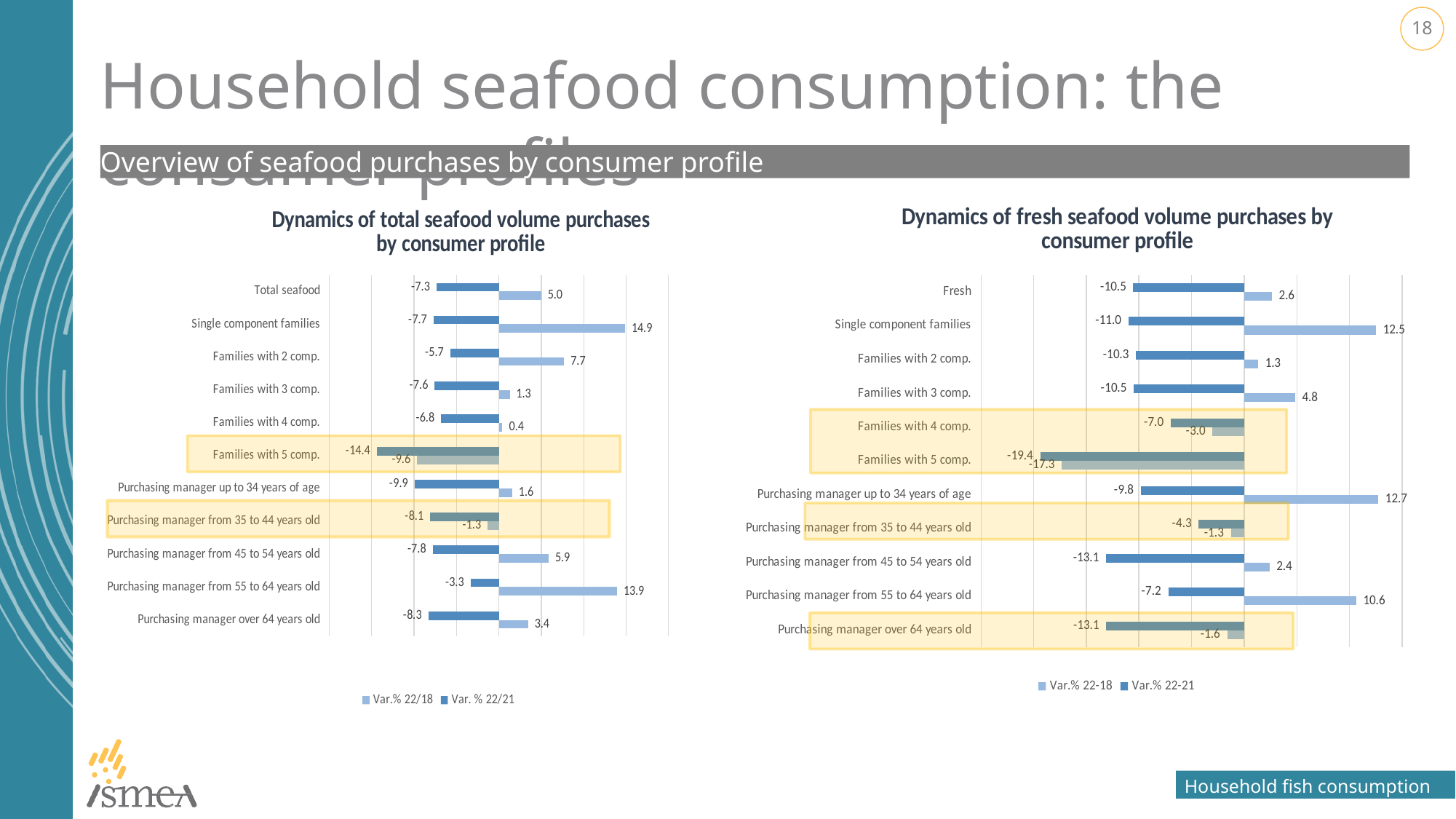
How many series does the legend of the 'Dynamics of fresh seafood volume purchases by consumer profile' chart list? 2 In the 'Dynamics of total seafood volume purchases by consumer profile' chart, what is the Var.% 22/18 value for Single component families? 14.9 In the 'Dynamics of fresh seafood volume purchases by consumer profile' chart, what is the Var.% 22-18 value for Families with 4 comp.? -3.0 In the 'Dynamics of total seafood volume purchases by consumer profile' chart, which category has the highest Var.% 22/18 value? Single component families In the 'Dynamics of total seafood volume purchases by consumer profile' chart, what is the Var. % 22/21 value for Families with 5 comp.? -14.4 In the 'Dynamics of fresh seafood volume purchases by consumer profile' chart, what is the Var.% 22-18 value for Purchasing manager from 55 to 64 years old? 10.6 How many consumer profile categories are shown in the 'Dynamics of total seafood volume purchases by consumer profile' chart? 11 What kind of chart is the 'Dynamics of total seafood volume purchases by consumer profile' chart? Bar chart In the 'Dynamics of fresh seafood volume purchases by consumer profile' chart, which category has the lowest Var.% 22-21 value? Families with 5 comp. In the 'Dynamics of total seafood volume purchases by consumer profile' chart, what is the difference between the Var.% 22/18 values for Single component families and Purchasing manager from 55 to 64 years old? 1.0 In the 'Dynamics of fresh seafood volume purchases by consumer profile' chart, which is larger for Families with 3 comp.: the Var.% 22-18 value or the Var.% 22-21 value? Var.% 22-18 In the 'Dynamics of fresh seafood volume purchases by consumer profile' chart, what is the Var.% 22-21 value for Purchasing manager from 45 to 54 years old? -13.1